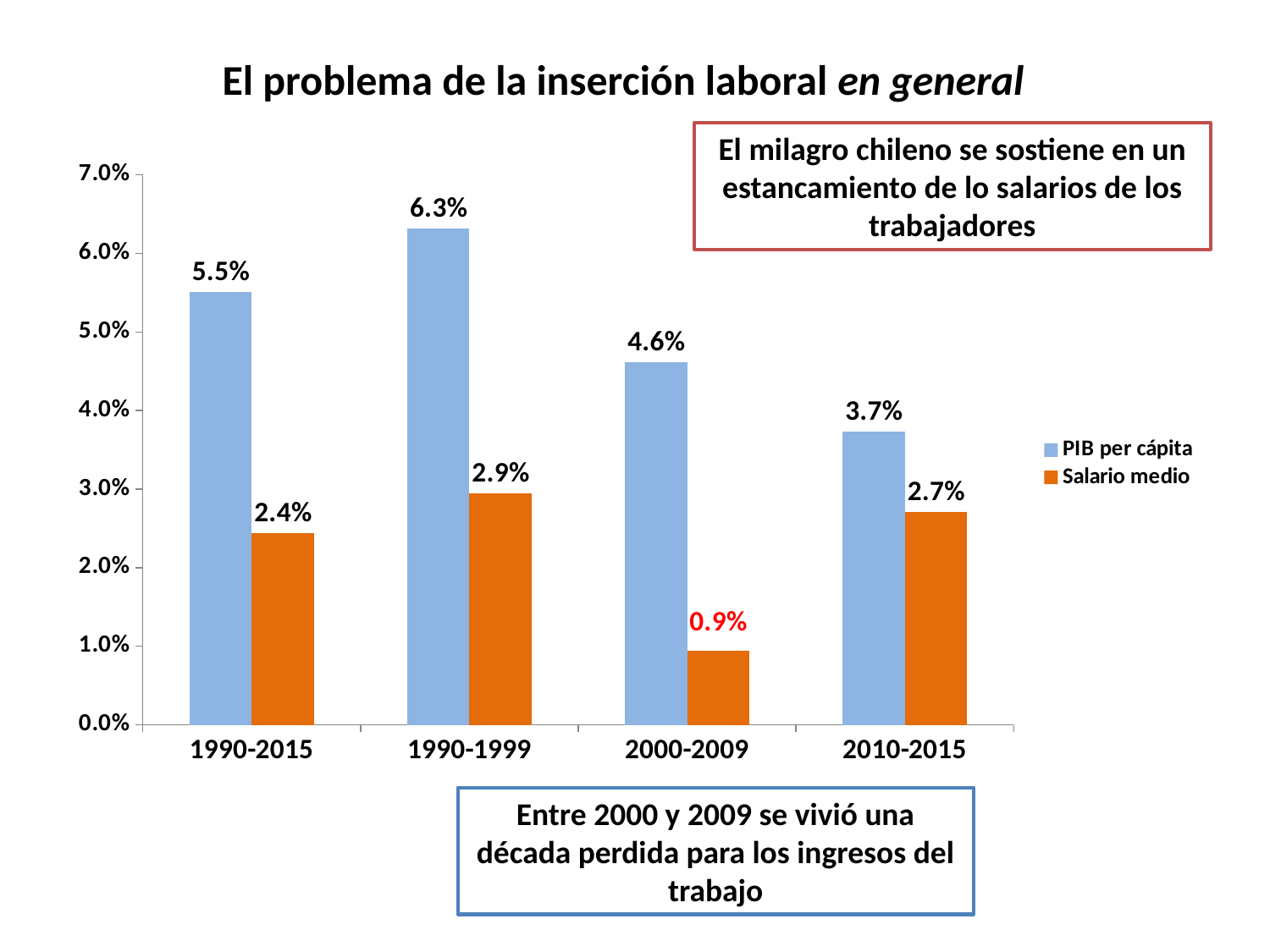
Which period has the highest PIB per cápita value? 1990-1999 Which series is shown in orange in the legend? Salario medio What kind of chart is shown on the slide? Bar chart Which period has the lowest Salario medio value? 2000-2009 How many periods are shown on the x axis? 4 What is the value of Salario medio for 2000-2009? 0.9% What is the value of PIB per cápita for 1990-1999? 6.3% Which is larger, Salario medio for 1990-1999 or Salario medio for 2010-2015? 1990-1999 What is the difference between PIB per cápita and Salario medio for 1990-2015? 3.1% What is the difference between PIB per cápita for 1990-1999 and for 2010-2015? 2.6% How many series does the legend list? 2 What is the value of Salario medio for 2010-2015? 2.7%